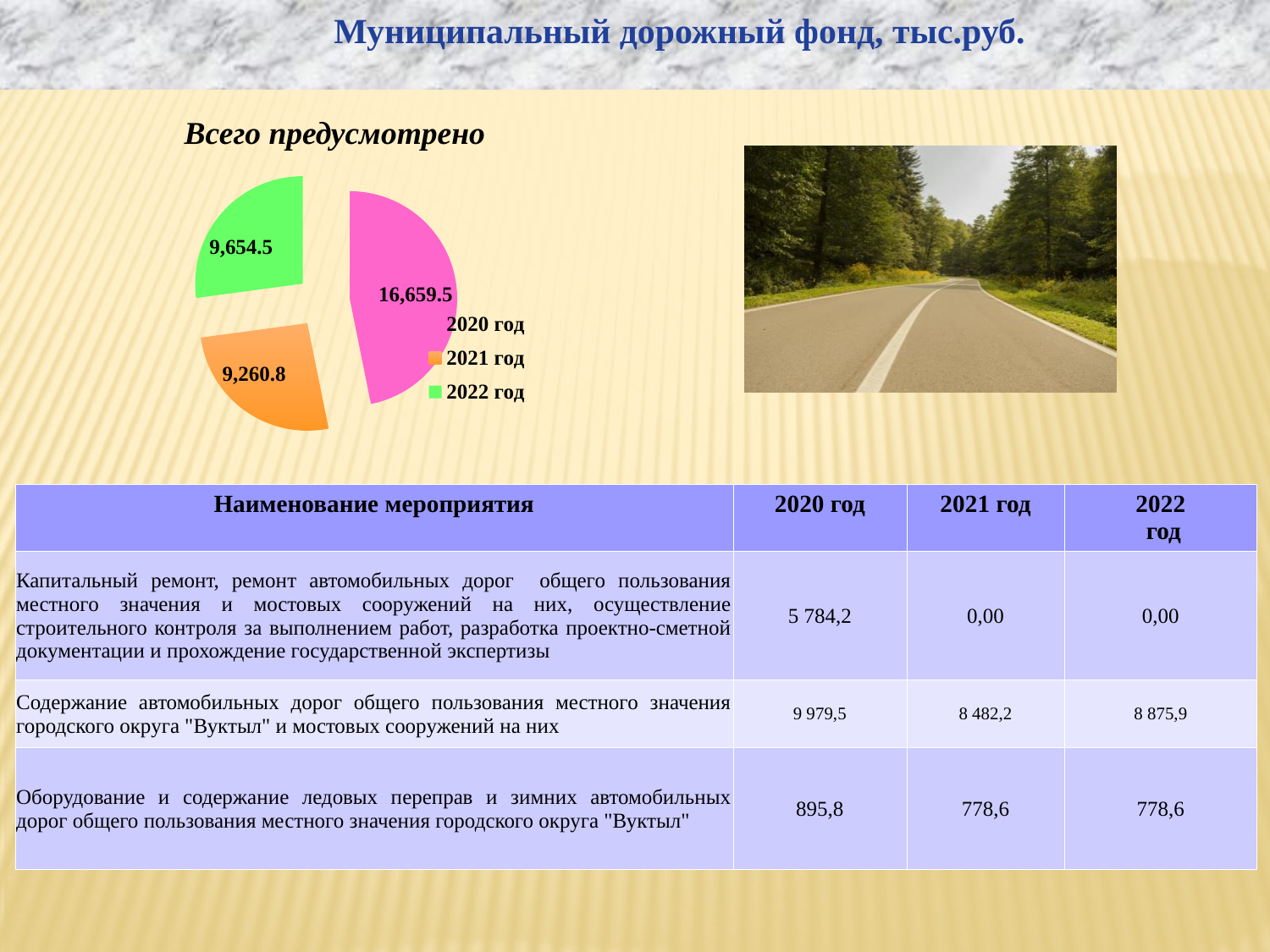
Which year has the largest slice in the pie chart? 2020 год How many entries does the pie chart's legend list? 3 How many slices does the pie chart have? 3 What type of chart is shown under the heading "Всего предусмотрено"? pie chart In the pie chart, what is the difference between the values for 2022 год and 2021 год? 393.7 In the pie chart, what is the value for 2022 год? 9,654.5 In the pie chart, what is the difference between the values for 2020 год and 2021 год? 7,398.7 In the pie chart, what is the value for 2021 год? 9,260.8 In the pie chart, what is the value for 2020 год? 16,659.5 What colour is the slice for 2022 год in the pie chart? green Which year has the smallest slice in the pie chart? 2021 год In the pie chart, which is larger: the value for 2021 год or for 2022 год? 2022 год